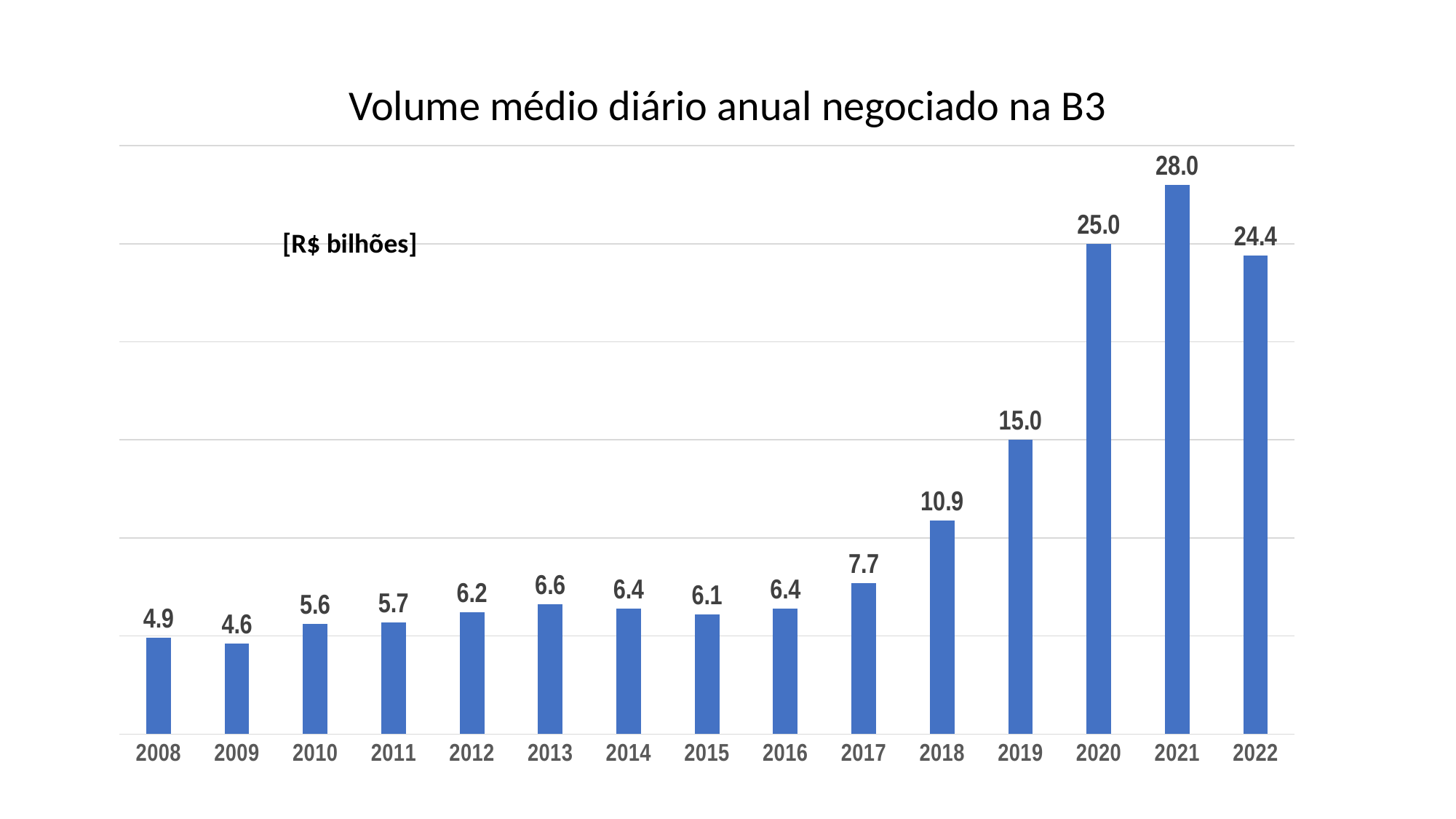
What is the value for 2021? 28.0 What is the difference between the values for 2021 and 2020? 3.0 What is the value for 2018? 10.9 Which is larger, the value for 2013 or the value for 2015? 2013 How many years are shown on the x axis? 15 Which is larger, the value for 2020 or the value for 2022? 2020 Which year has the lowest value? 2009 What is the value for 2008? 4.9 What is the title of the chart? Volume médio diário anual negociado na B3 What is the difference between the values for 2019 and 2018? 4.1 What kind of chart is shown on the slide? Bar chart Which year has the highest value? 2021